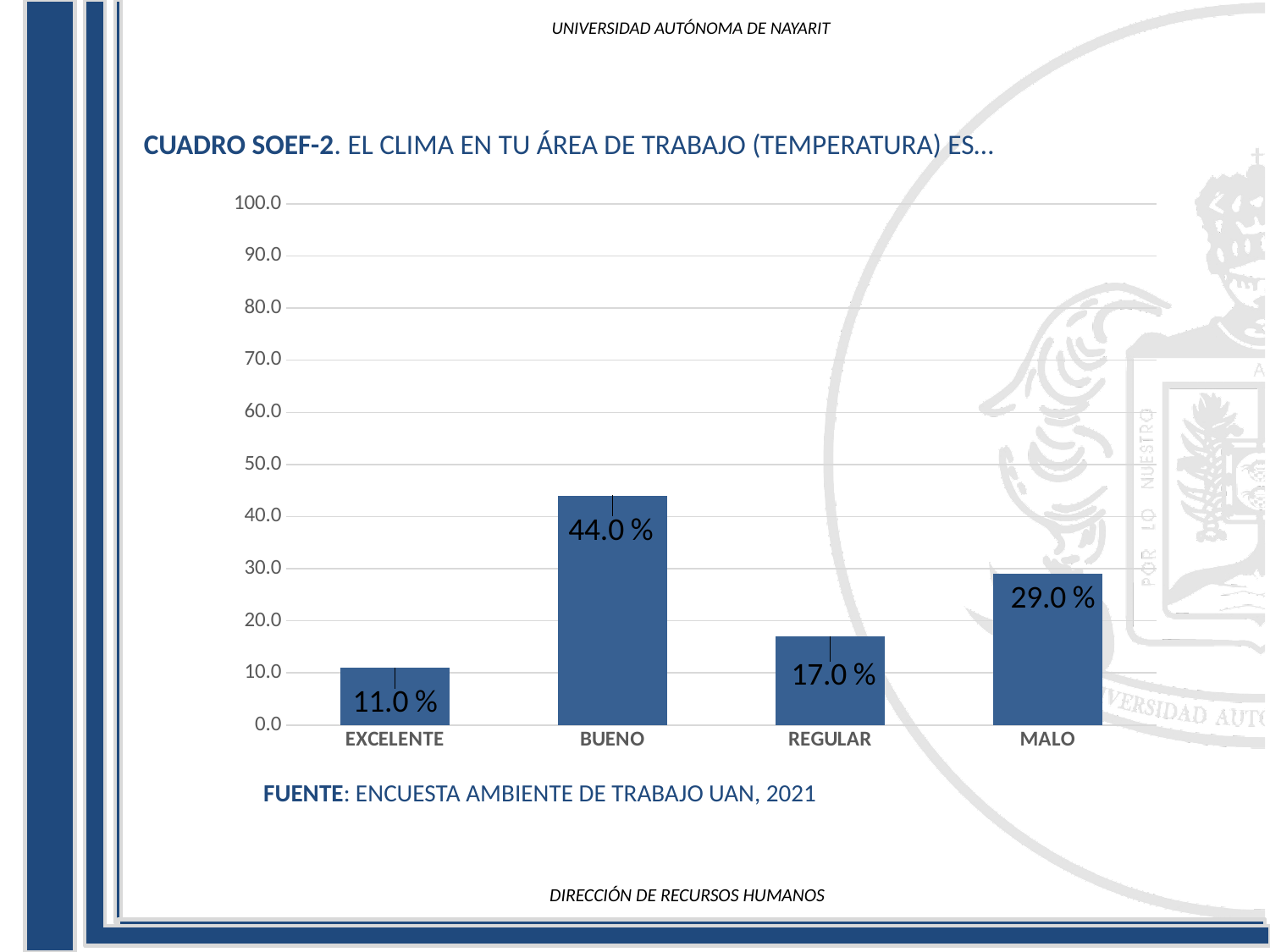
What kind of chart is shown on the slide? bar chart What is the value for EXCELENTE? 11.0 % What is the value for REGULAR? 17.0 % Which category has the highest value? BUENO What is the value for MALO? 29.0 % What is the value for BUENO? 44.0 % How many categories are shown on the x axis? 4 Which category has the lowest value? EXCELENTE What is the difference between the values for BUENO and MALO? 15.0 % Which is larger, the value for REGULAR or the value for MALO? MALO Is the value for BUENO greater or less than 50.0? less What source is cited below the chart? ENCUESTA AMBIENTE DE TRABAJO UAN, 2021